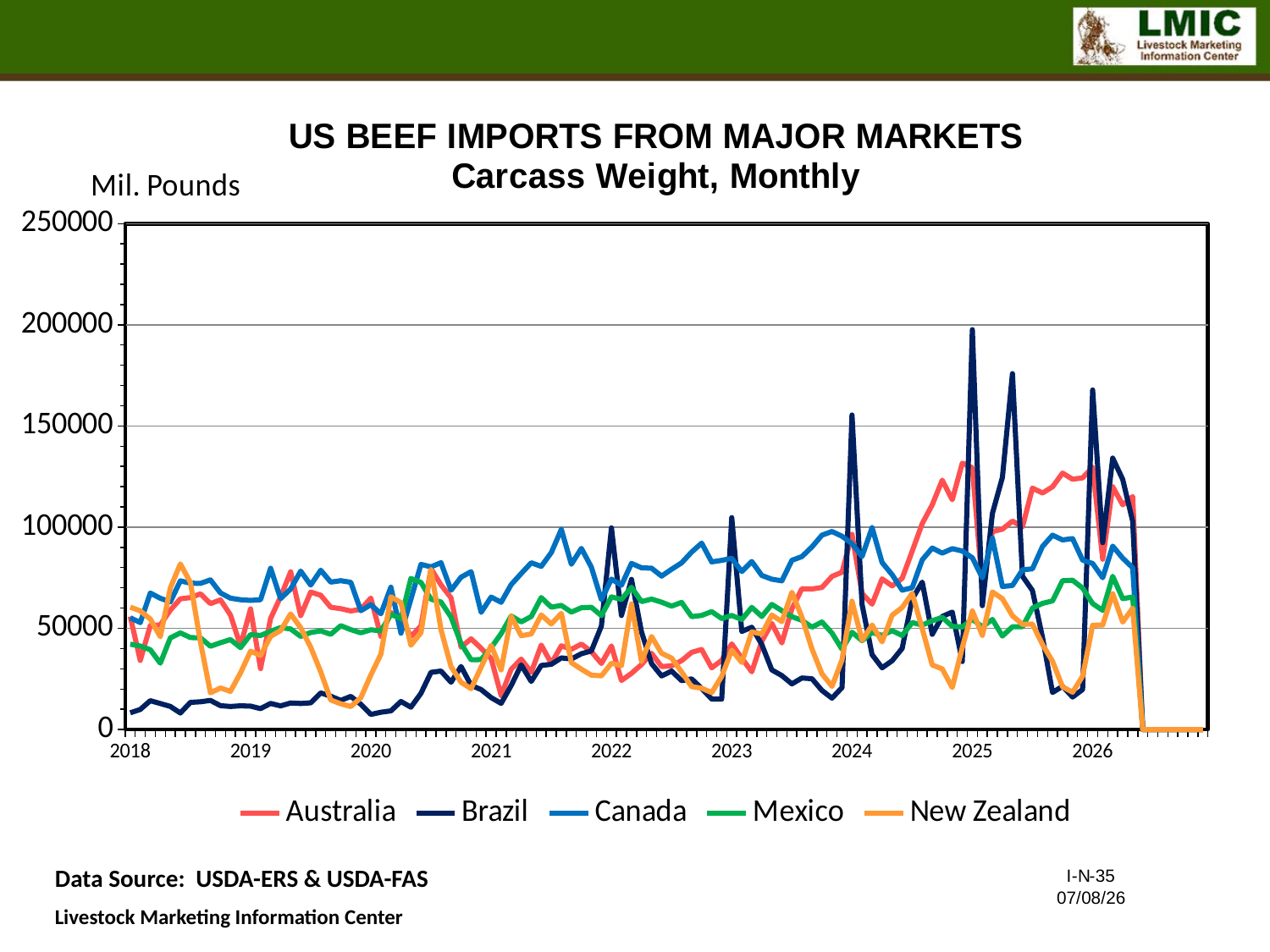
Around the start of 2025, which is higher, Australia or Mexico? Australia What unit label is shown on the y axis? Mil. Pounds Is the highest peak for Brazil in early 2025 greater or less than 150000? greater What kind of chart is shown on the slide? line chart Does the Australia series generally rise or fall between 2023 and 2025? rise At the start of 2018, which is higher, Canada or Brazil? Canada Is the value for Brazil at the start of 2018 greater or less than 50000? less Is the peak value for Australia around the start of 2025 greater or less than 100000? greater Which series reaches the highest value anywhere on the chart? Brazil Which series has the lowest values at the start of 2018? Brazil How many series does the legend list? 5 What is the title of the chart? US BEEF IMPORTS FROM MAJOR MARKETS Carcass Weight, Monthly